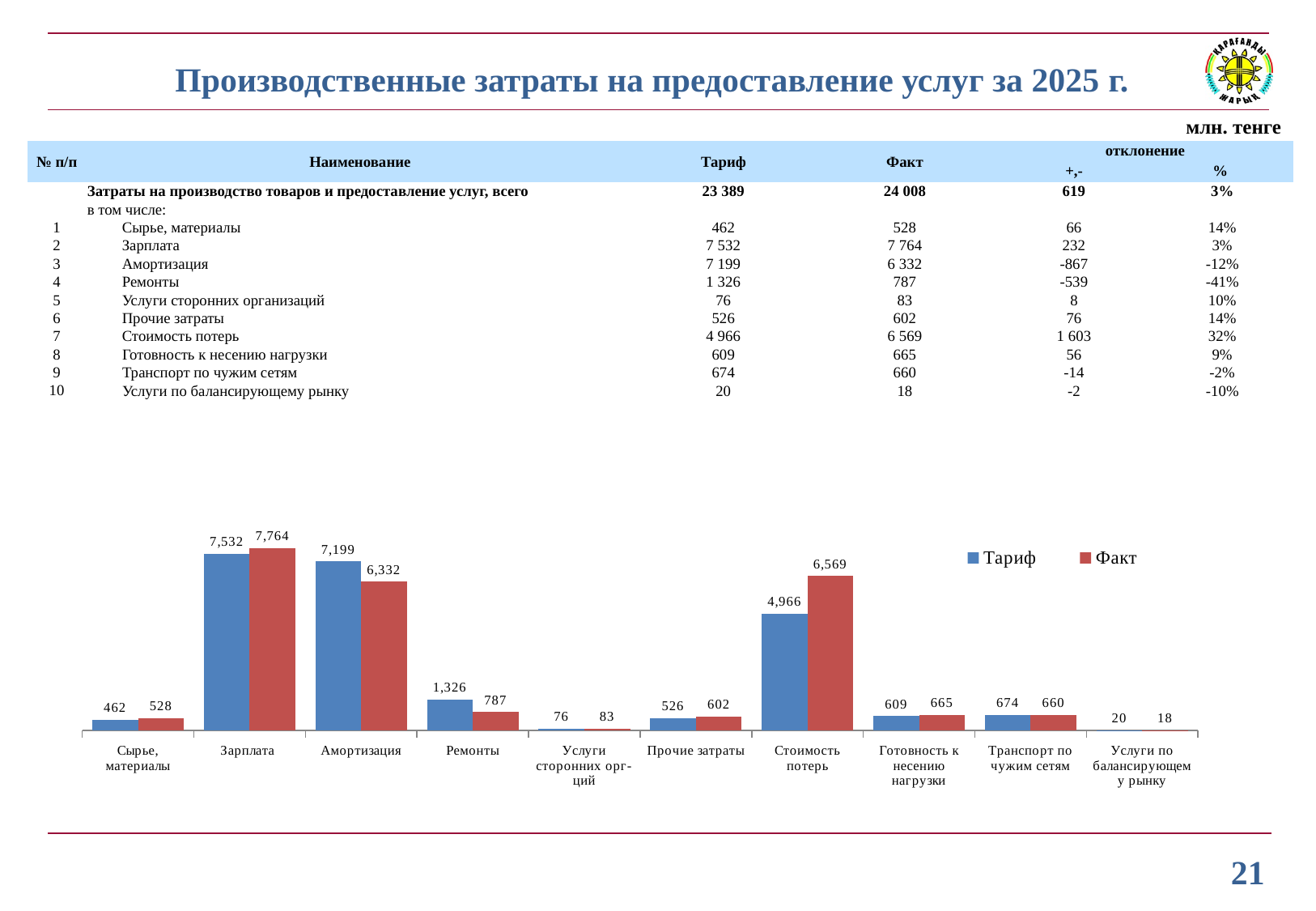
What is the difference between the Факт and Тариф values for Амортизация in the chart? 867 What is the Тариф value for Стоимость потерь in the chart? 4,966 What type of chart is shown on the slide? bar chart What is the Факт value for Зарплата in the chart? 7,764 What is the Факт value for Ремонты in the chart? 787 How many series does the chart legend list? 2 Which series is shown in red in the chart? Факт Which category has the lowest Тариф value in the chart? Услуги по балансирующему рынку Which category has the highest Факт value in the chart? Зарплата For Стоимость потерь, which is larger in the chart: Тариф or Факт? Факт What is the difference between the Факт and Тариф values for Сырье, материалы in the chart? 66 How many categories are shown on the x axis of the chart? 10